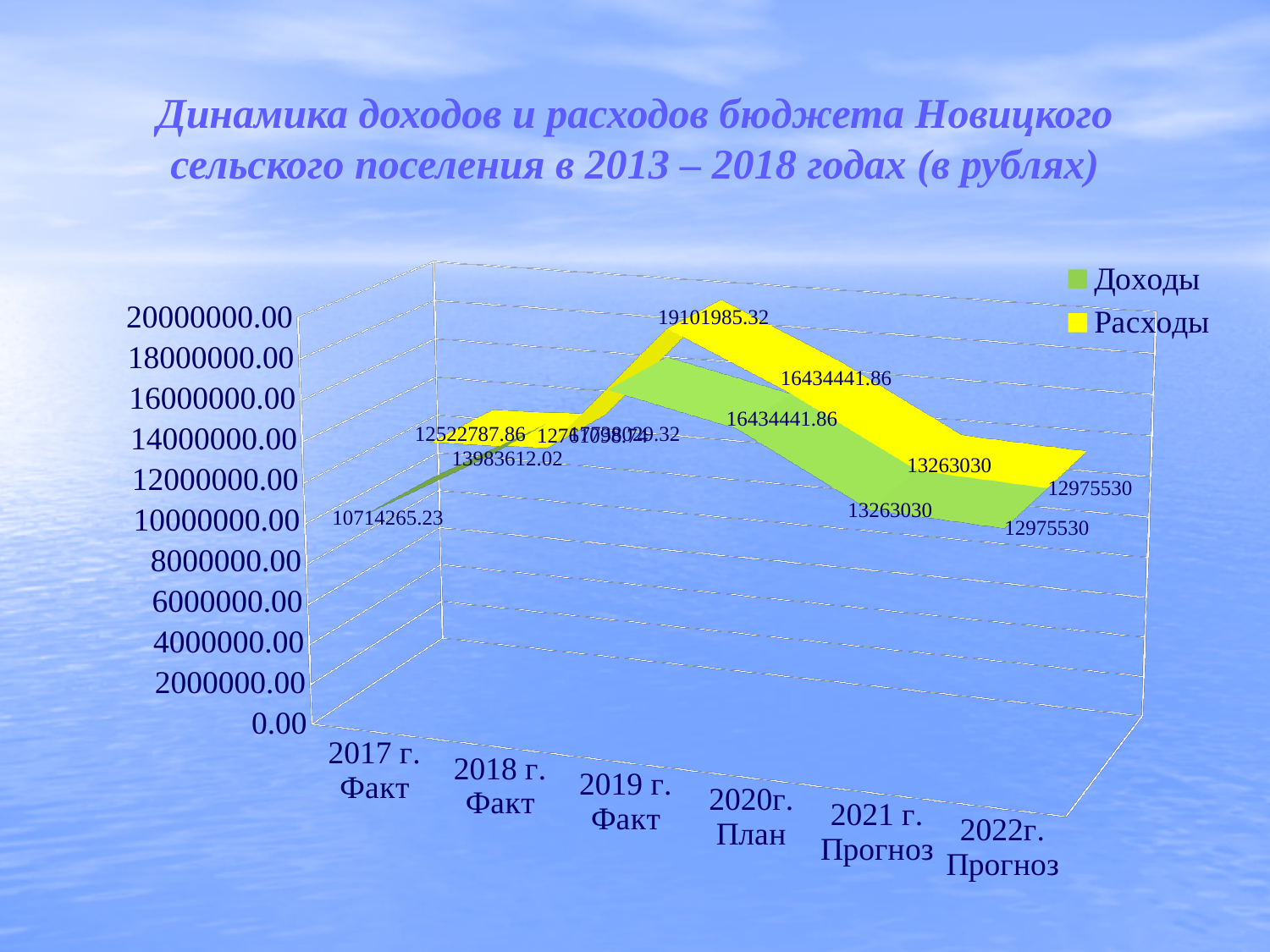
In which category is Доходы lowest? 2017 г. Факт What is the value of Расходы for 2022г. Прогноз? 12975530 What type of chart is shown on the slide? Line chart (3D) What is the value of Доходы for 2017 г. Факт? 10714265.23 Do the Расходы values rise or fall from 2020г. План to 2022г. Прогноз? Fall What is the value of Доходы for 2021 г. Прогноз? 13263030 What is the difference between Доходы for 2021 г. Прогноз and Доходы for 2022г. Прогноз? 287500 How many categories are shown along the x axis? 6 How many series does the legend list? 2 In which category is Расходы highest? 2019 г. Факт What is the value of Расходы for 2020г. План? 16434441.86 What is the value of Расходы for 2019 г. Факт? 19101985.32